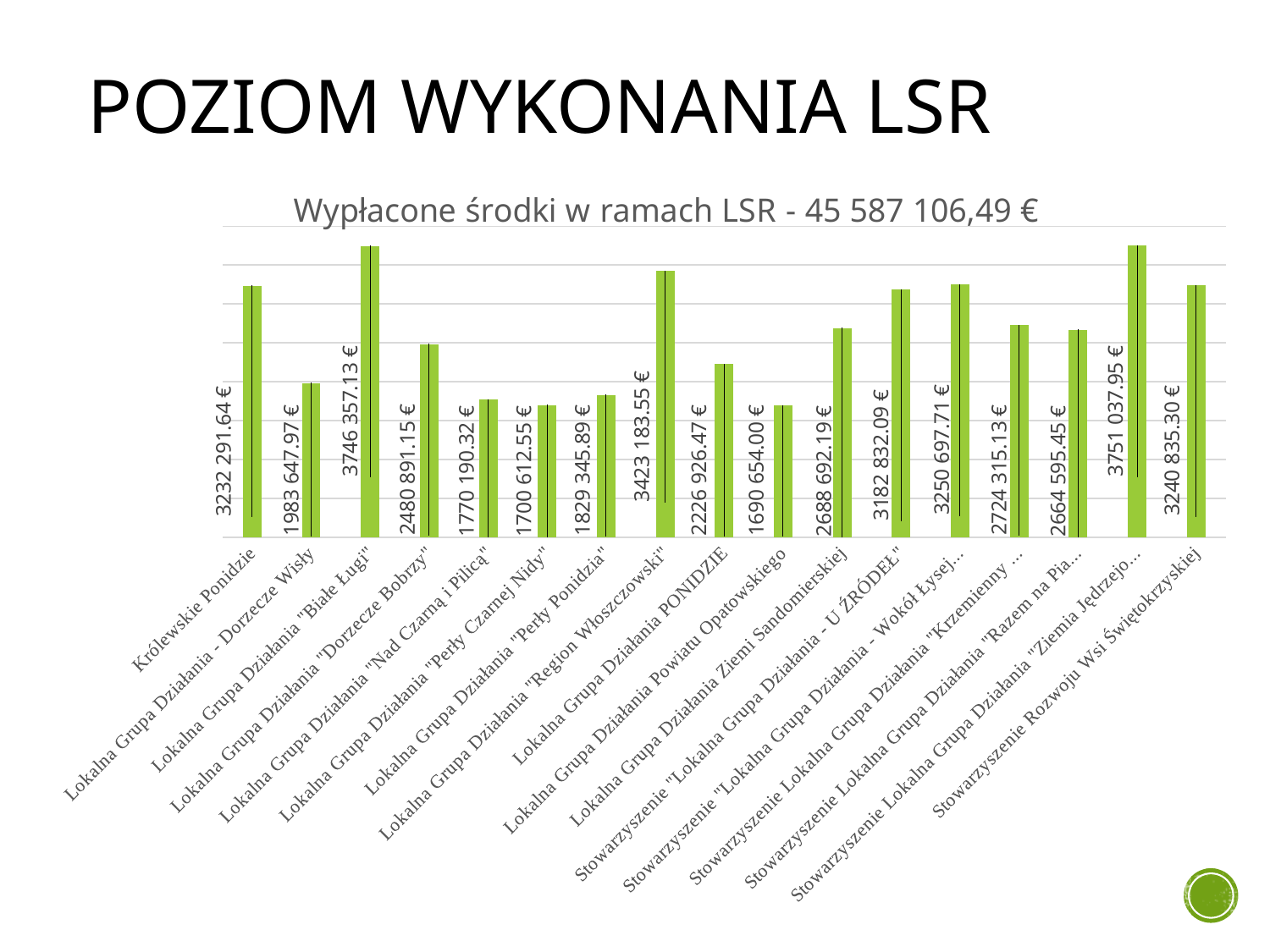
What is the difference between the values for Lokalna Grupa Działania "Białe Ługi" and Lokalna Grupa Działania "Region Włoszczowski"? 323 173.58 € Which has a larger value: Lokalna Grupa Działania Ziemi Sandomierskiej or Lokalna Grupa Działania "Perły Ponidzia"? Lokalna Grupa Działania Ziemi Sandomierskiej What value is shown for Lokalna Grupa Działania "Region Włoszczowski"? 3423 183.55 € What value is shown for Królewskie Ponidzie? 3232 291.64 € What kind of chart is shown on the slide? Bar chart What total amount is stated in the chart title? 45 587 106,49 € How many categories (bars) are shown in the chart? 17 What value is shown for Lokalna Grupa Działania Powiatu Opatowskiego? 1690 654.00 € What is the difference between the values for Królewskie Ponidzie and Lokalna Grupa Działania - Dorzecze Wisły? 1248 643.67 € What value is shown for Stowarzyszenie Rozwoju Wsi Świętokrzyskiej? 3240 835.30 € What value is shown for Lokalna Grupa Działania PONIDZIE? 2226 926.47 € Which has a larger value: Królewskie Ponidzie or Lokalna Grupa Działania "Dorzecze Bobrzy"? Królewskie Ponidzie